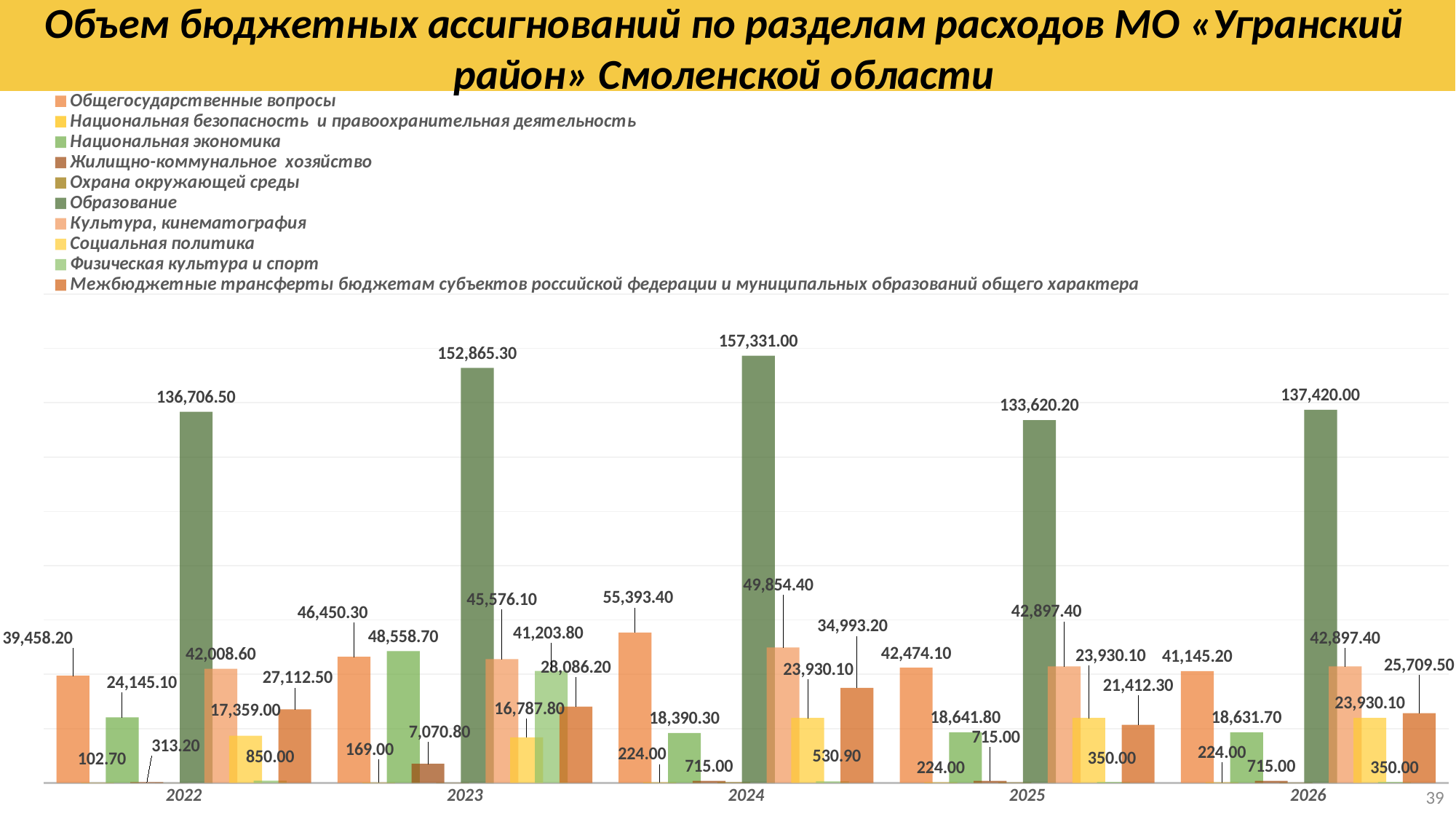
In which year is the value for Образование the highest? 2024 What is the value for Образование in 2024? 157,331.00 What is the difference between the Общегосударственные вопросы values for 2024 and 2025? 12,919.30 In which year is the value for Образование the lowest? 2025 Which series has the tallest bar in every year? Образование Which year has the larger value for Общегосударственные вопросы, 2023 or 2024? 2024 How many series does the legend list? 10 What is the value for Межбюджетные трансферты бюджетам субъектов российской федерации и муниципальных образований общего характера in 2024? 34,993.20 What is the difference between the Образование values for 2024 and 2023? 4,465.70 What kind of chart is shown on the slide? Bar chart What is the value for Национальная экономика in 2023? 48,558.70 How many years are shown on the x axis? 5